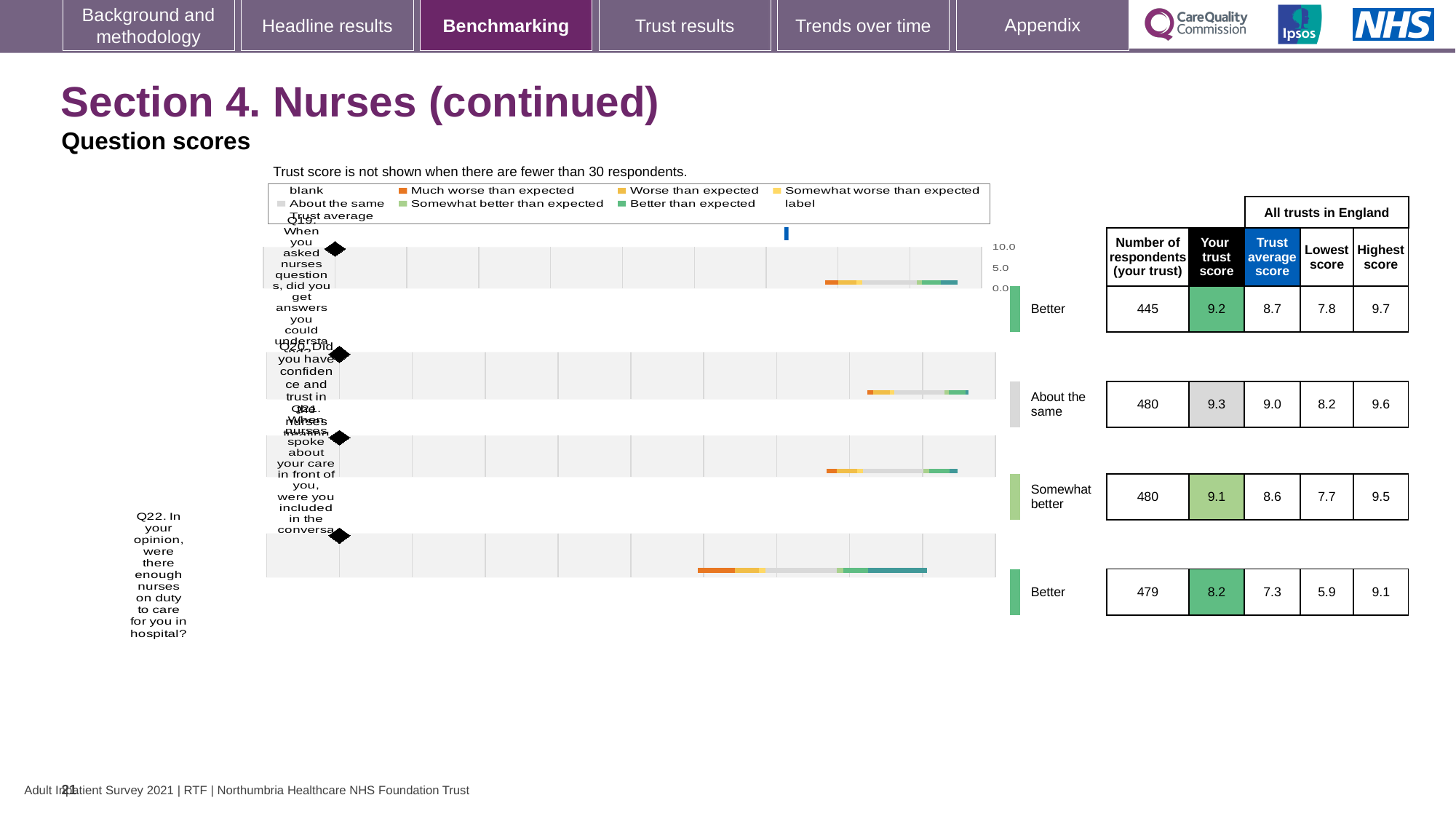
What benchmark category label is shown for Q20? About the same How many respondents from your trust answered Q19? 445 What is the 'Your trust score' value for Q22 (enough nurses on duty)? 8.2 What is the lowest score across all trusts in England for Q22? 5.9 For Q19, which is larger: the trust score or the trust average score? the trust score (9.2) What is the highest score across all trusts in England for Q21? 9.5 Which question has the lowest 'Your trust score'? Q22 How many questions (Q19 to Q22) are plotted in the chart? 4 What kind of chart is used to show the question scores on this slide? bar chart Which question has the highest 'Your trust score'? Q20 What is the difference between the trust score and the trust average score for Q22? 0.9 Is the trust score for Q22 greater or less than 5.0 on the axis? greater